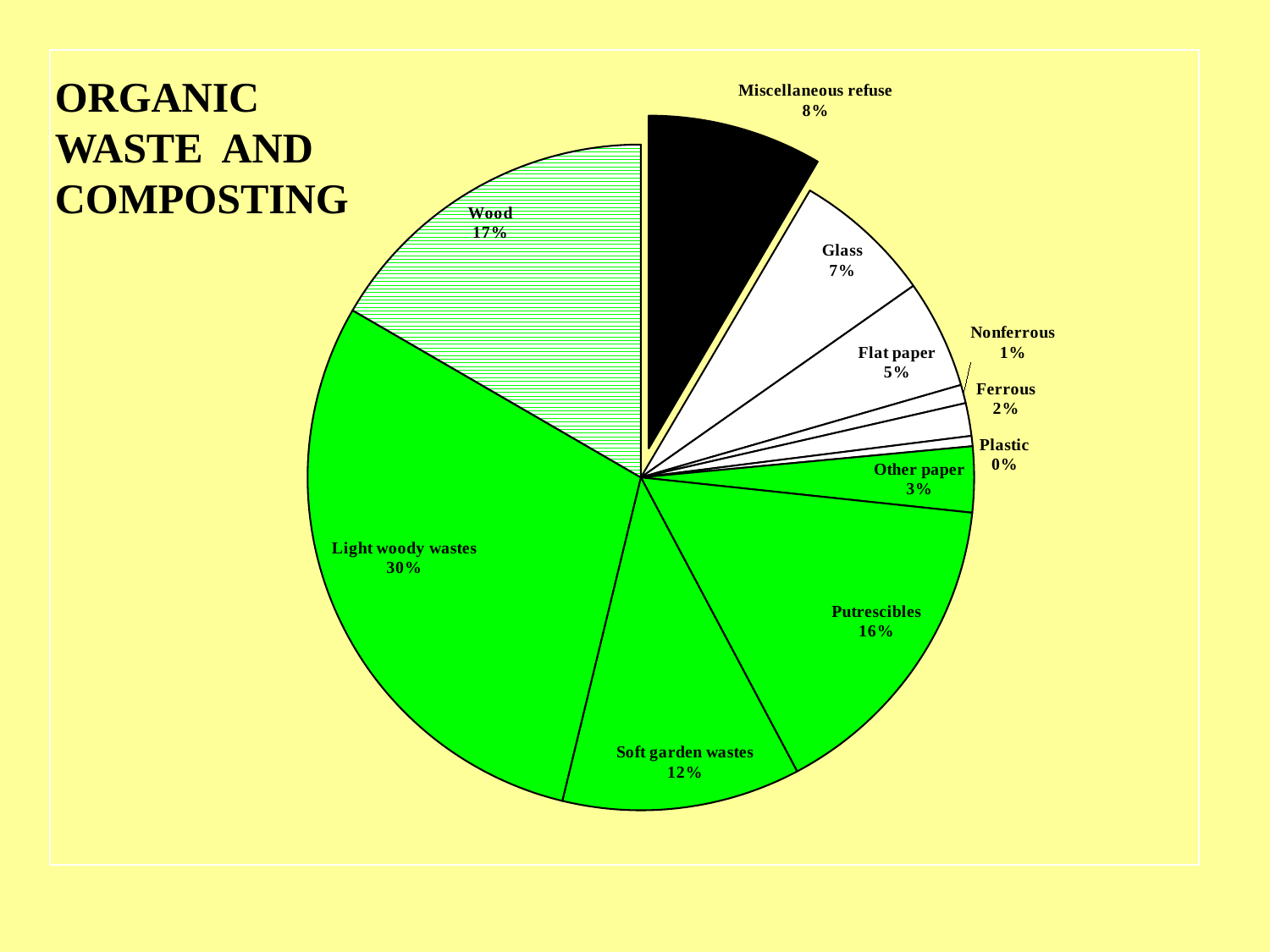
What is the combined share of Soft garden wastes and Putrescibles? 28% What percentage of the pie is Putrescibles? 16% What type of chart is shown on the slide? pie chart Which category has the smallest share of the pie? Plastic How many categories are shown in the pie chart? 11 What is the difference in percentage points between Light woody wastes and Wood? 13 Which category has the largest share of the pie? Light woody wastes What percentage of the pie is Miscellaneous refuse? 8% Which is larger, Glass or Flat paper? Glass Which slice of the pie is coloured black? Miscellaneous refuse What percentage of the pie is Wood? 17% What percentage of the pie is Light woody wastes? 30%